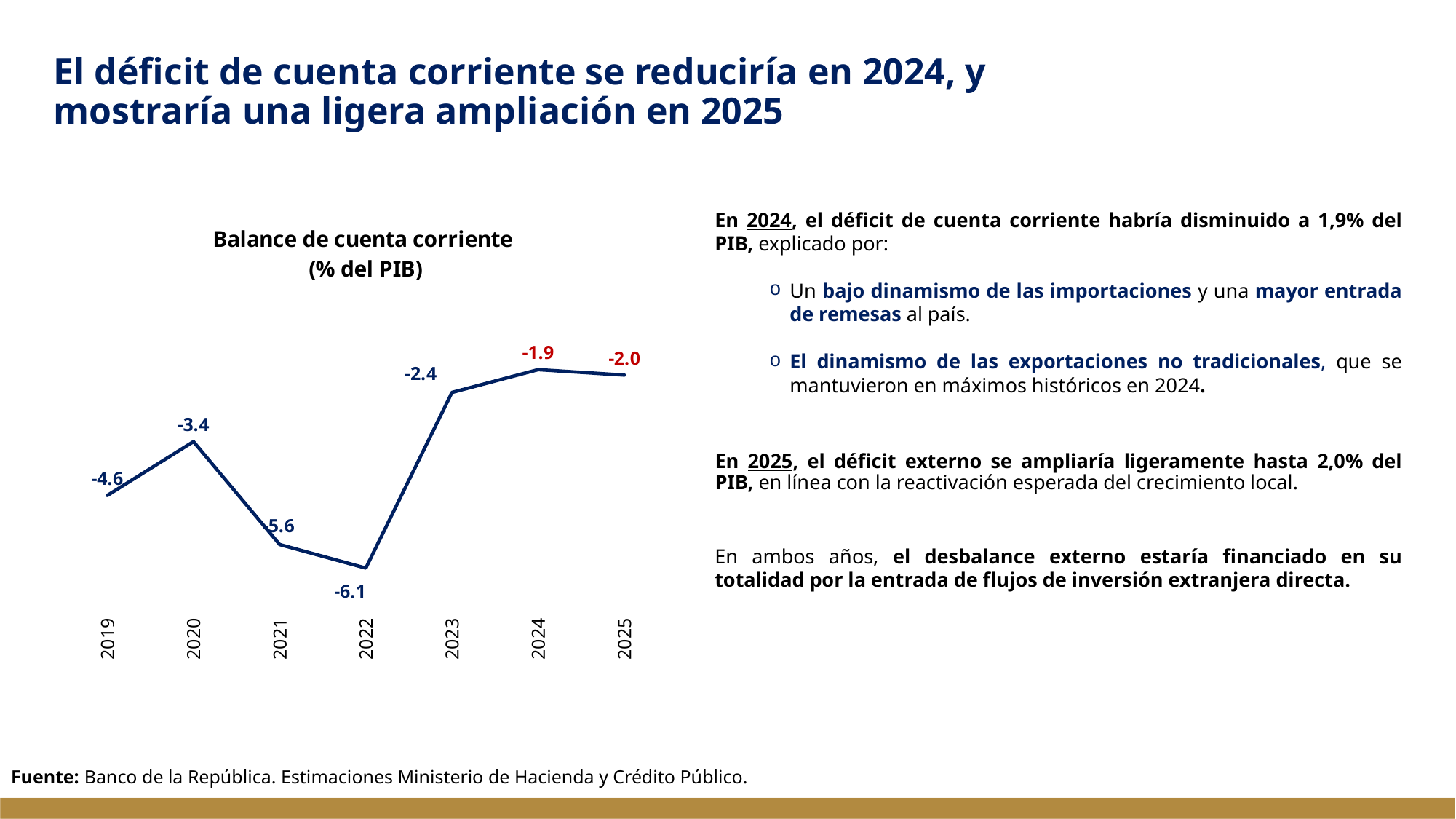
What unit is given in the subtitle of the 'Balance de cuenta corriente' chart? % del PIB What is the value for 2025 in the 'Balance de cuenta corriente' chart? -2.0 In the 'Balance de cuenta corriente' chart, does the value rise or fall from 2020 to 2022? fall What is the value for 2019 in the 'Balance de cuenta corriente' chart? -4.6 Which year has the lowest value in the 'Balance de cuenta corriente' chart? 2022 Which year has the highest value in the 'Balance de cuenta corriente' chart? 2024 What is the value for 2022 in the 'Balance de cuenta corriente' chart? -6.1 Which is larger in the 'Balance de cuenta corriente' chart, the value for 2020 or the value for 2021? 2020 How many years are plotted in the 'Balance de cuenta corriente' chart? 7 What is the difference between the values for 2023 and 2022 in the 'Balance de cuenta corriente' chart? 3.7 What kind of chart is the 'Balance de cuenta corriente' chart? line chart What is the value for 2024 in the 'Balance de cuenta corriente' chart? -1.9